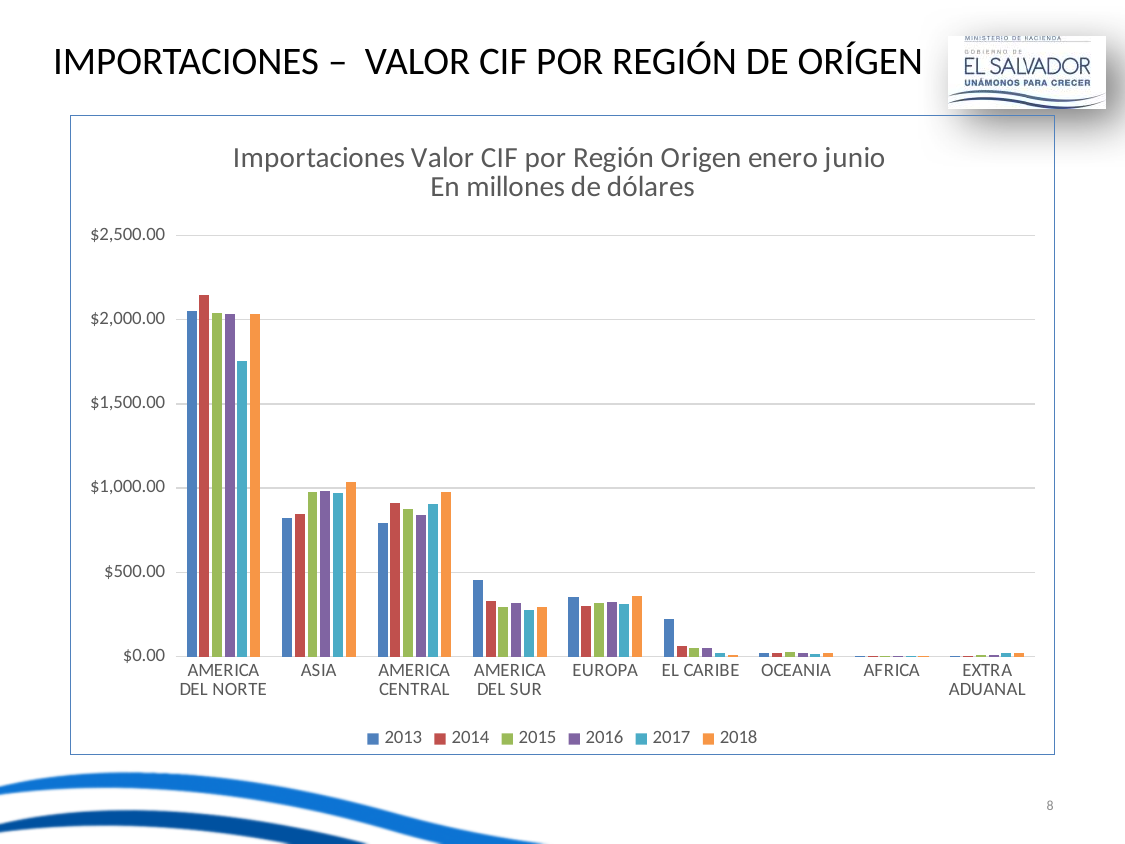
Is the 2013 value for ASIA greater or less than $1,000.00? less How many regions are shown on the x axis? 9 Which region has the highest value for 2014? AMERICA DEL NORTE Is the 2013 value for AMERICA DEL SUR greater or less than $500.00? less What is the title of the chart? Importaciones Valor CIF por Región Origen enero junio En millones de dólares For EL CARIBE, which is larger: the 2013 value or the 2018 value? 2013 Do the values for ASIA generally rise or fall from 2013 to 2018? rise How many series does the legend list? 6 Is the 2017 value for AMERICA DEL NORTE greater or less than $2,000.00? less What kind of chart is shown on the slide? bar chart For AMERICA DEL NORTE, which year has the tallest bar? 2014 For AMERICA DEL NORTE, which is larger: the 2014 value or the 2017 value? 2014